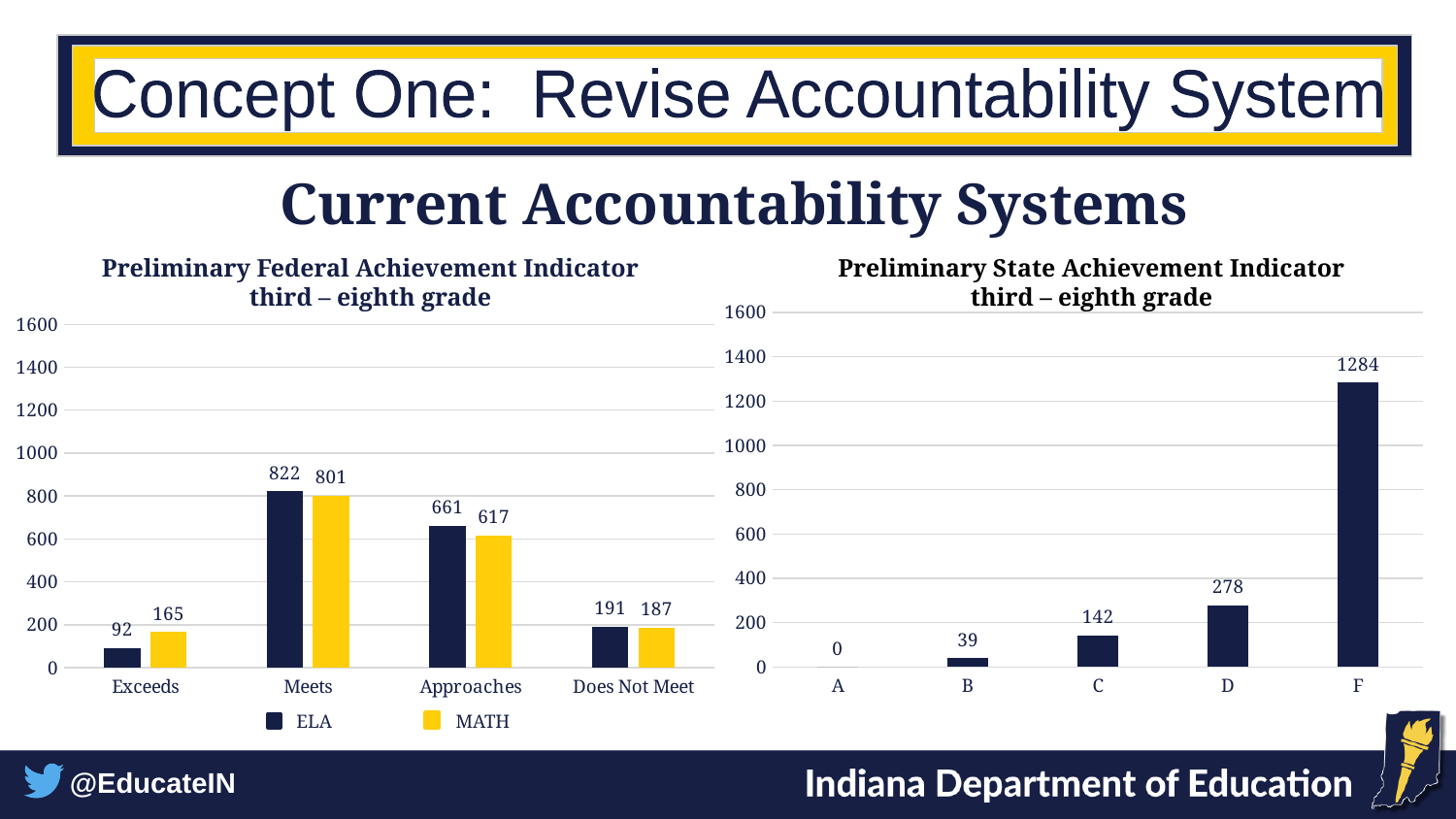
In the Preliminary Federal Achievement Indicator chart, which category has the lowest MATH value? Exceeds How many categories are shown on the x axis of the Preliminary Federal Achievement Indicator chart? 4 In the Preliminary State Achievement Indicator chart, which grade has the highest value? F In the Preliminary Federal Achievement Indicator chart, what is the MATH value for Exceeds? 165 In the Preliminary State Achievement Indicator chart, what is the difference between the values for F and D? 1006 In the Preliminary Federal Achievement Indicator chart, which is larger for Does Not Meet, ELA or MATH? ELA In the Preliminary State Achievement Indicator chart, what is the value for grade D? 278 In the Preliminary Federal Achievement Indicator chart, what is the ELA value for Meets? 822 How many series does the legend of the Preliminary Federal Achievement Indicator chart list? 2 In the Preliminary Federal Achievement Indicator chart, what is the difference between the ELA and MATH values for Approaches? 44 What kind of chart is the Preliminary State Achievement Indicator chart? Bar chart In the Preliminary Federal Achievement Indicator chart, which category has the highest ELA value? Meets